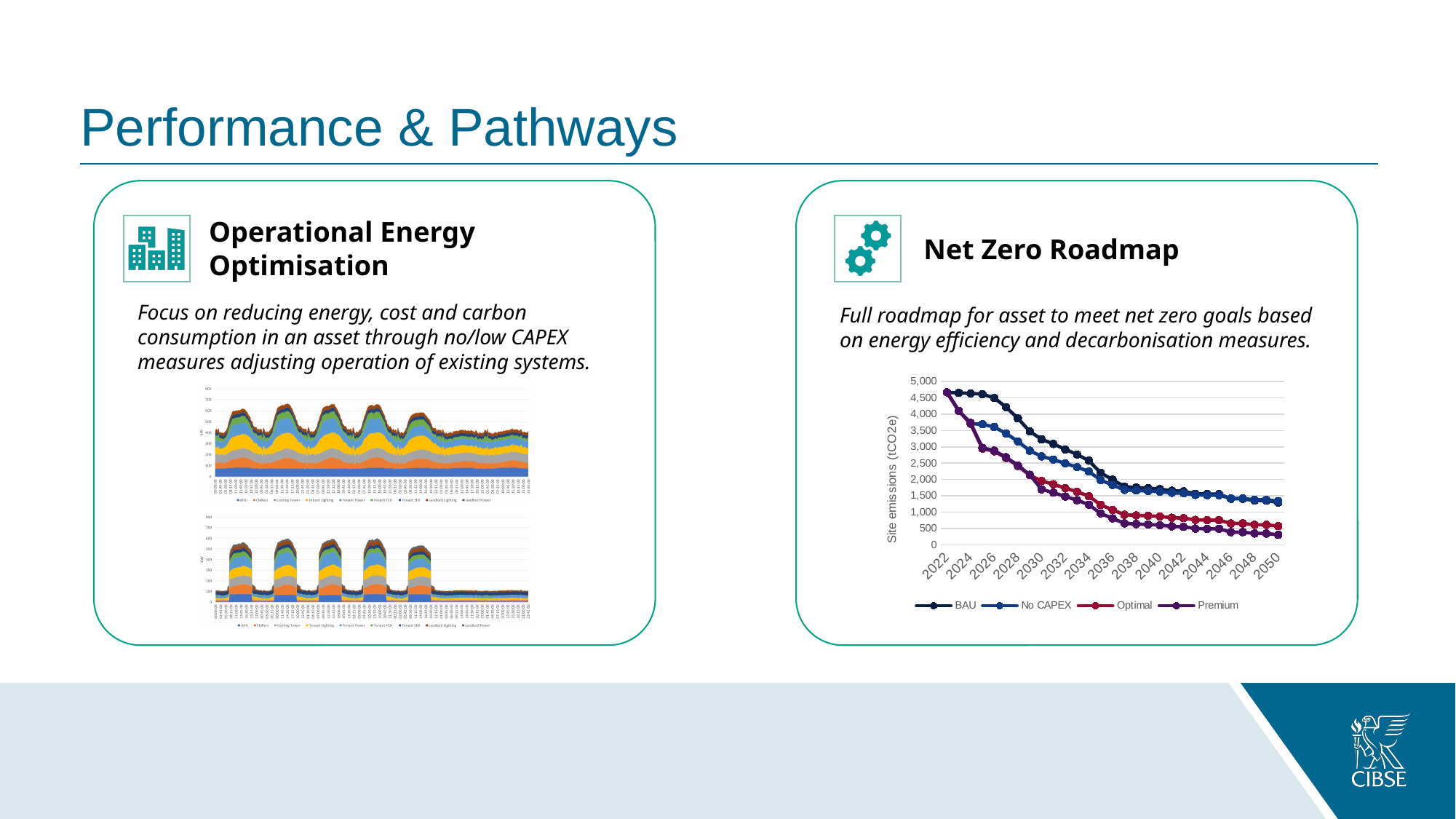
In the Net Zero Roadmap chart, which series has the highest emissions in 2030? BAU In the Net Zero Roadmap chart, what is the highest value shown on the y axis? 5,000 In the Net Zero Roadmap chart, is the Premium value in 2050 greater or less than 500? less In the Net Zero Roadmap chart, which series has the lowest emissions in 2050? Premium In the Net Zero Roadmap chart, is the Premium value in 2030 greater or less than 2,500? less In the Net Zero Roadmap chart, do the site emissions values rise or fall from 2022 to 2050? Fall What kind of chart is the Net Zero Roadmap chart? Line chart What is the y-axis label of the Net Zero Roadmap chart? Site emissions (tCO2e) In the Net Zero Roadmap chart, how many series does the legend list? 4 In the Net Zero Roadmap chart, which is larger in 2030: BAU or No CAPEX? BAU In the Net Zero Roadmap chart, is the BAU value in 2050 greater or less than 1,000? greater